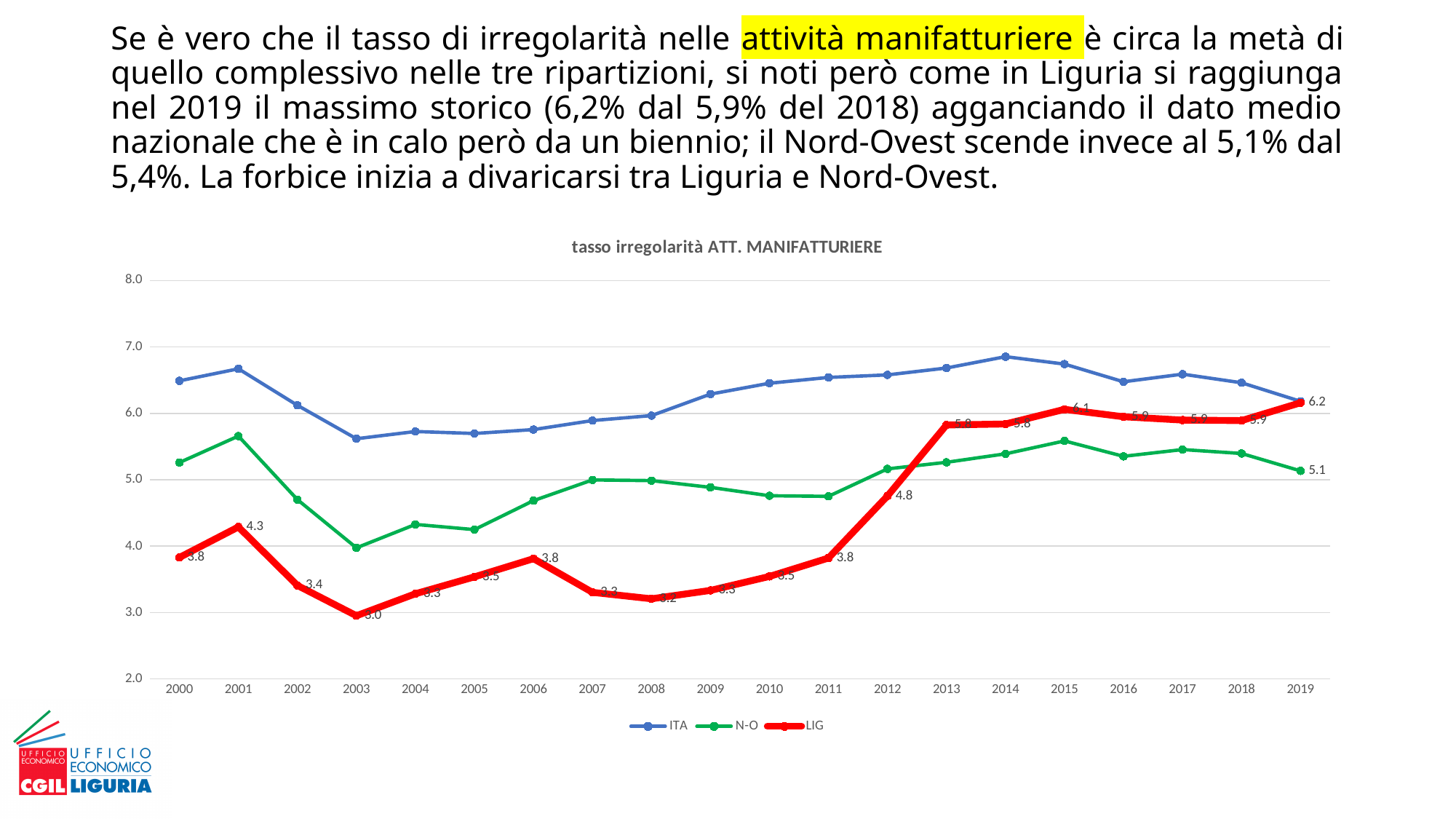
What is the title of the chart? tasso irregolarità ATT. MANIFATTURIERE What is the value for N-O in 2019? 5.1 Is the value for ITA in 2014 greater or less than 6.0? greater Which series has the larger value in 2010, ITA or N-O? ITA What is the value for LIG in 2019? 6.2 How many series does the legend list? 3 In which year is the LIG series at its highest? 2019 How many years are shown on the x axis? 20 What kind of chart is shown on the slide? line chart What is the value for LIG in 2003? 3.0 What is the difference between the LIG values for 2019 and 2018? 0.3 In which year is the LIG series at its lowest? 2003